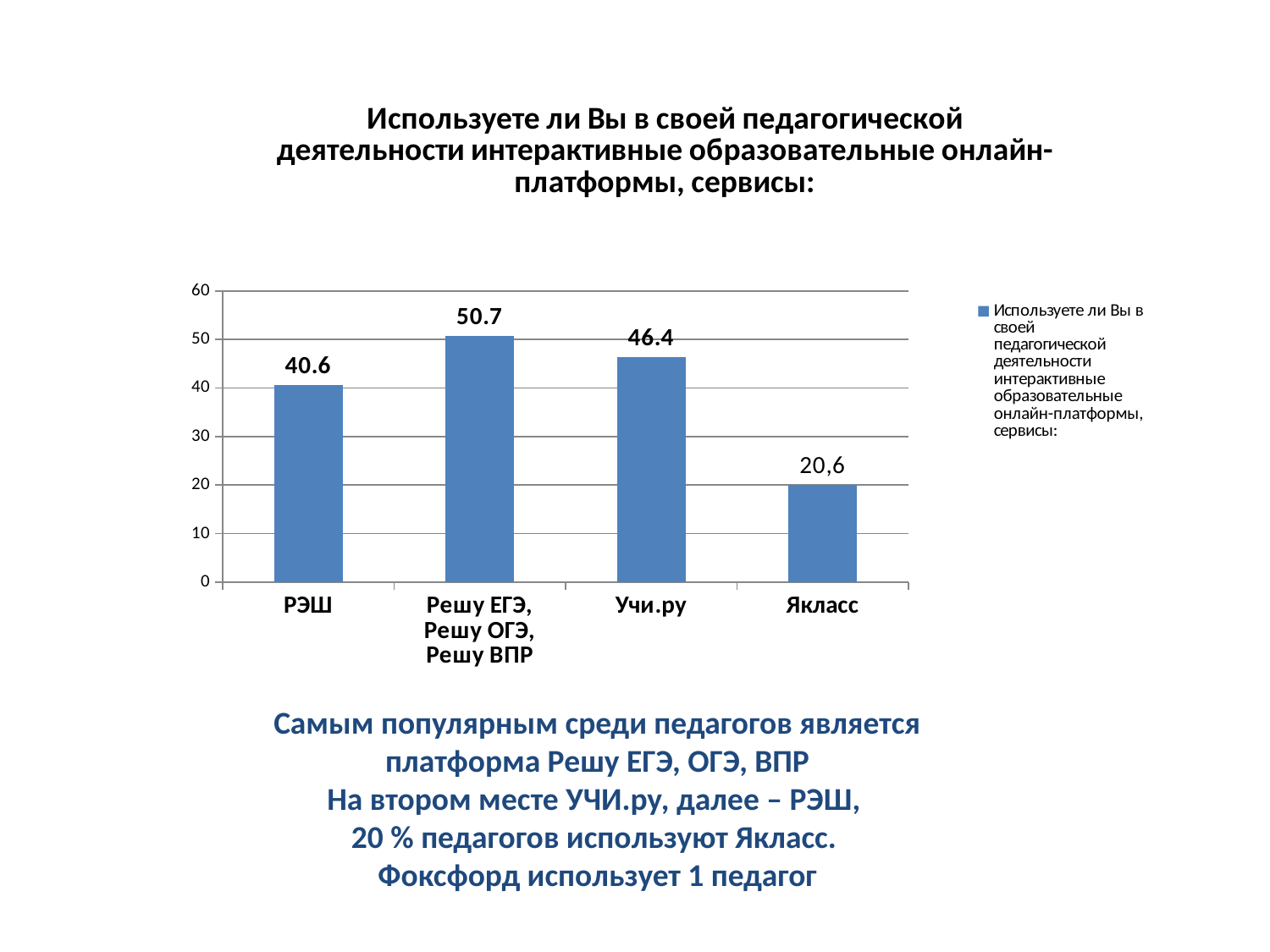
Which category has the highest value? Решу ЕГЭ, Решу ОГЭ, Решу ВПР What is the value for Учи.ру? 46.4 Which is larger, the value for Учи.ру or the value for РЭШ? Учи.ру What is the value for Якласс? 20,6 What is the difference between the values for Решу ЕГЭ, Решу ОГЭ, Решу ВПР and РЭШ? 10.1 What is the value for Решу ЕГЭ, Решу ОГЭ, Решу ВПР? 50.7 What is the value for РЭШ? 40.6 Is the value for Якласс greater or less than 30? less What kind of chart is shown on the slide? bar chart Which category has the lowest value? Якласс How many categories are shown on the x axis? 4 What is the difference between the values for Учи.ру and РЭШ? 5.8